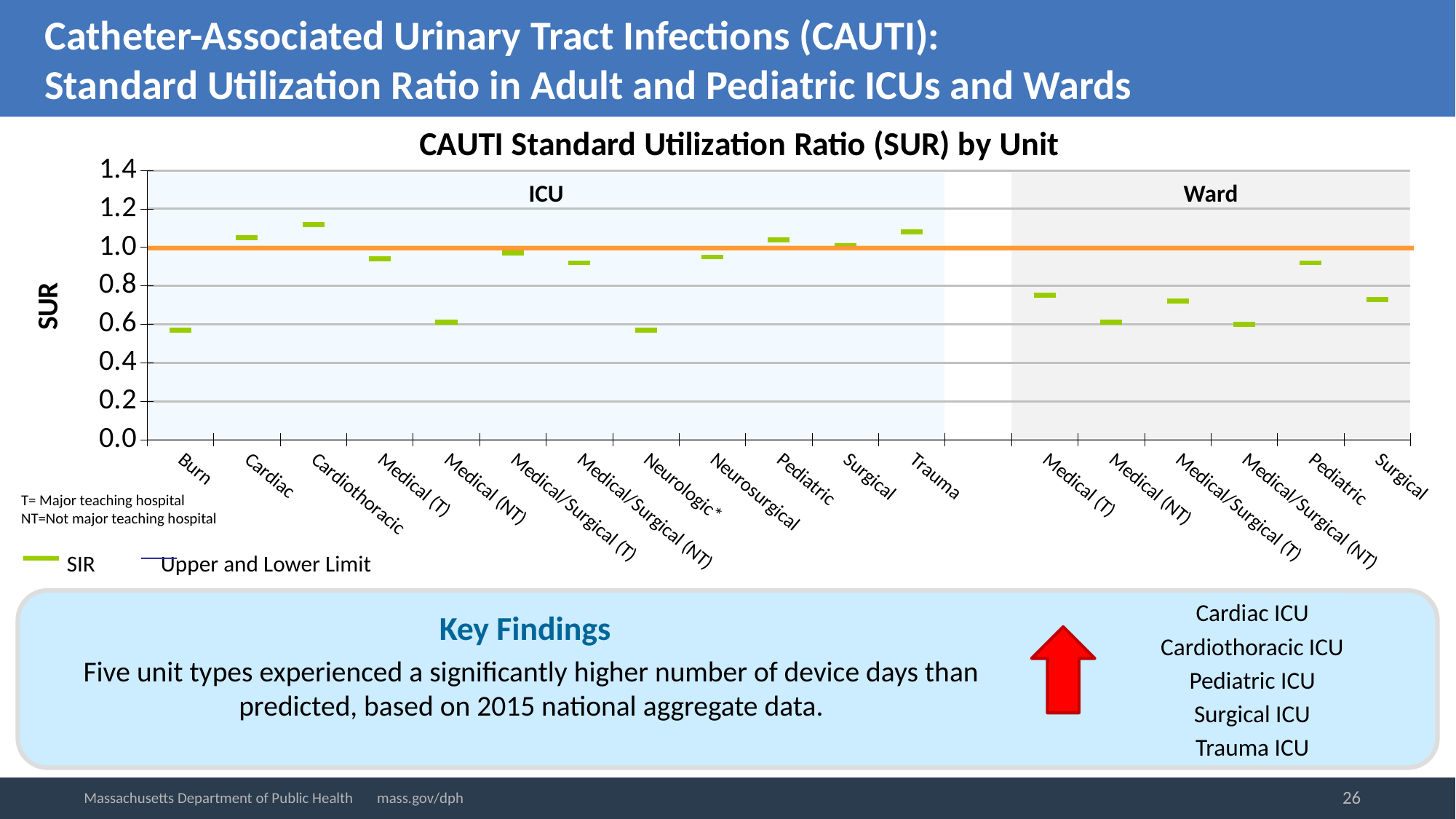
Is the SUR value for the Burn ICU greater or less than 0.8? less What is the title of the chart? CAUTI Standard Utilization Ratio (SUR) by Unit What is the label on the vertical axis of the chart? SUR Is the SUR value for the Cardiothoracic ICU greater or less than 1.0? greater Is the SUR value for the Medical/Surgical (NT) ward greater or less than 0.8? less Which has the larger SUR value: the Cardiothoracic ICU or the Burn ICU? Cardiothoracic ICU Which unit has the highest SUR value on the chart? Cardiothoracic (ICU) Which has the larger SUR value in the Ward section: Pediatric or Medical (NT)? Pediatric How many unit categories are plotted in the Ward section of the chart? 6 How many series does the chart legend list? 2 How many unit categories are plotted on the x axis in total? 18 How many unit categories are plotted in the ICU section of the chart? 12